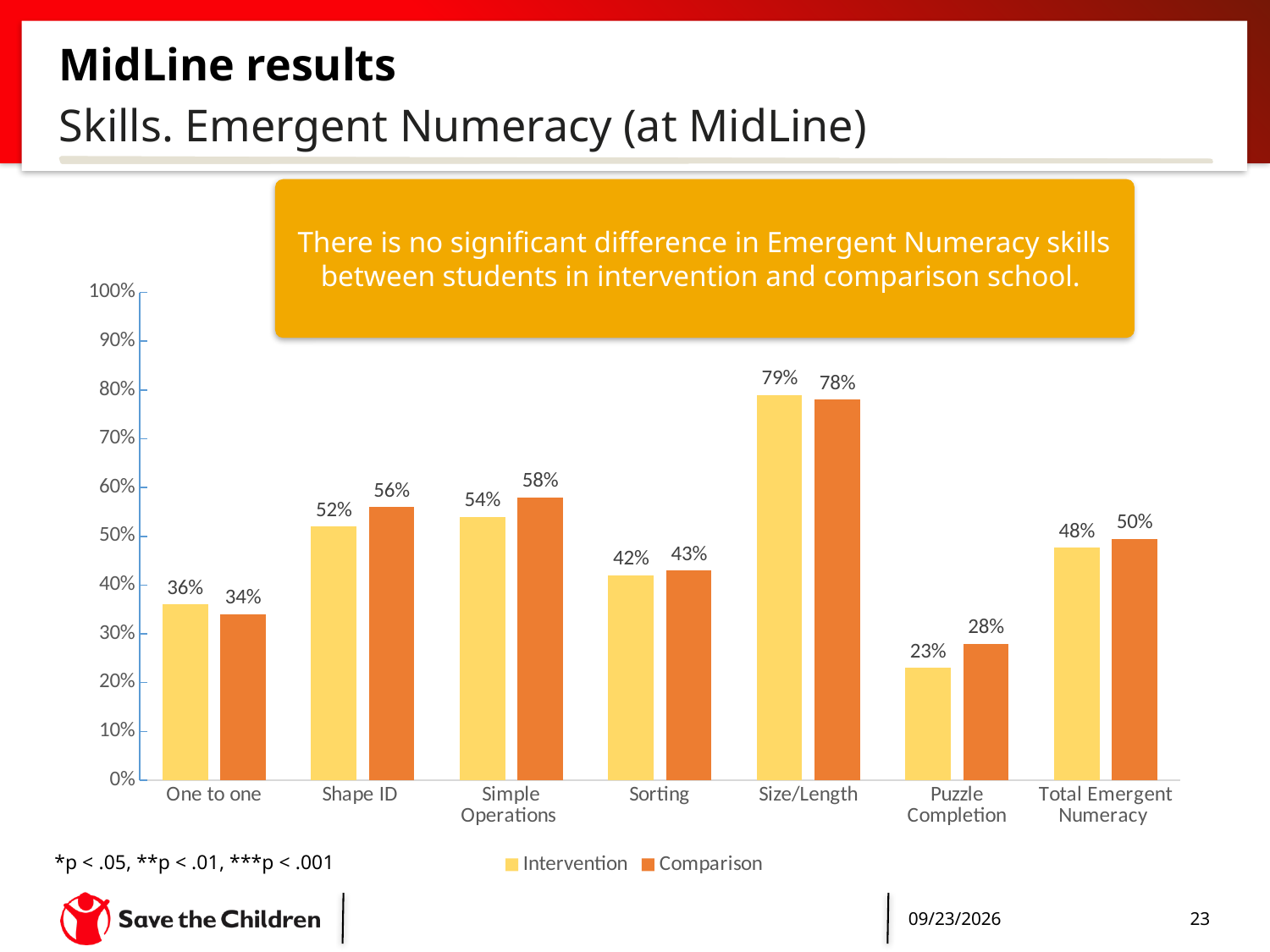
What is the Intervention value for Total Emergent Numeracy? 48% What is the Intervention value for Size/Length? 79% How many categories are shown on the x axis? 7 Which category has the highest Comparison value? Size/Length Which series is shown in orange in the legend? Comparison What is the Comparison value for Puzzle Completion? 28% What is the difference between the Comparison and Intervention values for Shape ID? 4% What kind of chart is shown on the slide? bar chart Which category has the lowest Intervention value? Puzzle Completion How many series does the legend list? 2 For One to one, which series has the larger value, Intervention or Comparison? Intervention Is the Comparison value for Sorting greater or less than 50%? less